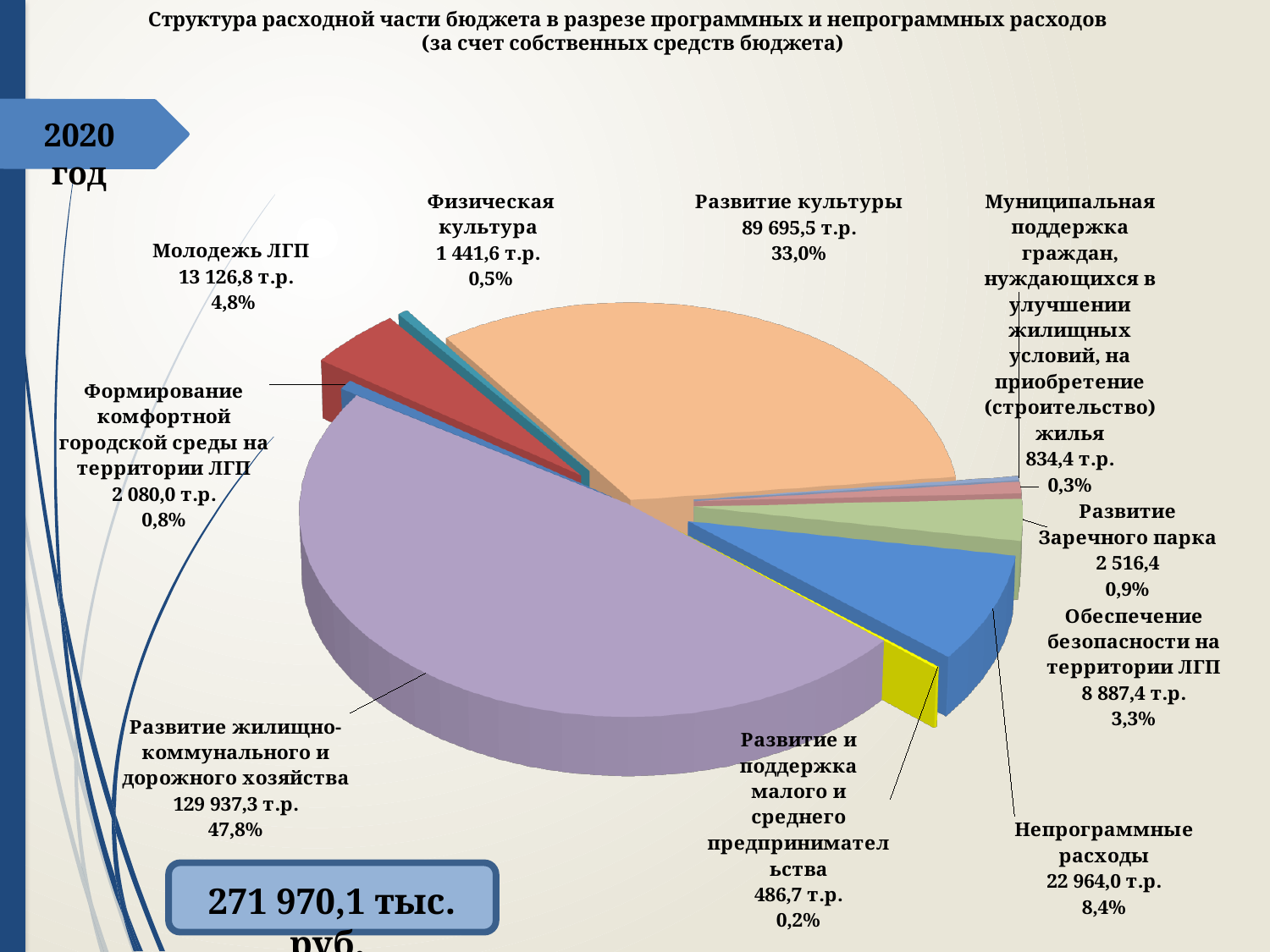
What is the difference in percentage points between «Развитие жилищно-коммунального и дорожного хозяйства» (47,8%) and «Развитие культуры» (33,0%)? 14,8% Which category has the smallest share of the pie? Развитие и поддержка малого и среднего предпринимательства What is the value for «Муниципальная поддержка граждан, нуждающихся в улучшении жилищных условий, на приобретение (строительство) жилья»? 834,4 т.р. Which category has the largest share of the pie? Развитие жилищно-коммунального и дорожного хозяйства What share of the pie does «Развитие жилищно-коммунального и дорожного хозяйства» represent? 47,8% What kind of chart is shown on the slide? Pie chart What is the value for «Непрограммные расходы»? 22 964,0 т.р. Which is larger: «Молодежь ЛГП» or «Обеспечение безопасности на территории ЛГП»? Молодежь ЛГП What share of the pie does «Физическая культура» represent? 0,5% What is the value for «Развитие культуры»? 89 695,5 т.р. How many categories (slices) does the pie chart have? 10 What total amount is shown in the box below the chart? 271 970,1 тыс. руб.